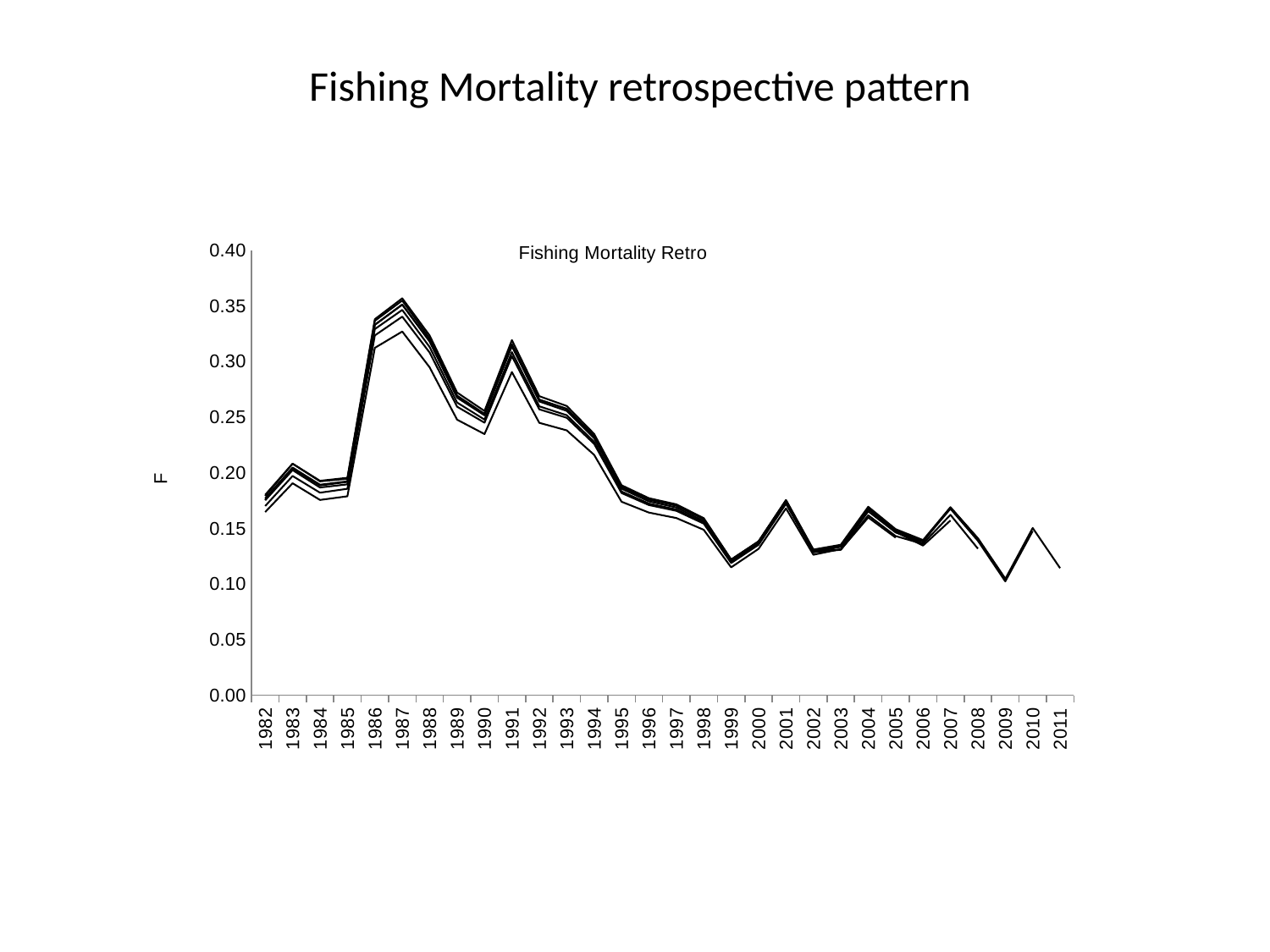
Is the value for 1991 greater or less than 0.25? greater How many years are shown along the x axis of the chart? 30 Is the value for 1987 greater or less than 0.30? greater Which year has the highest fishing mortality values in the chart? 1987 Is the value for 2009 greater or less than 0.15? less Which year has the larger fishing mortality value, 2001 or 2009? 2001 Which year has the larger fishing mortality value, 1983 or 1986? 1986 What is the label on the vertical axis of the chart? F What is the title printed inside the chart area? Fishing Mortality Retro Do the fishing mortality values generally rise or fall from 1987 to 2011? fall What kind of chart is shown on the slide? line chart